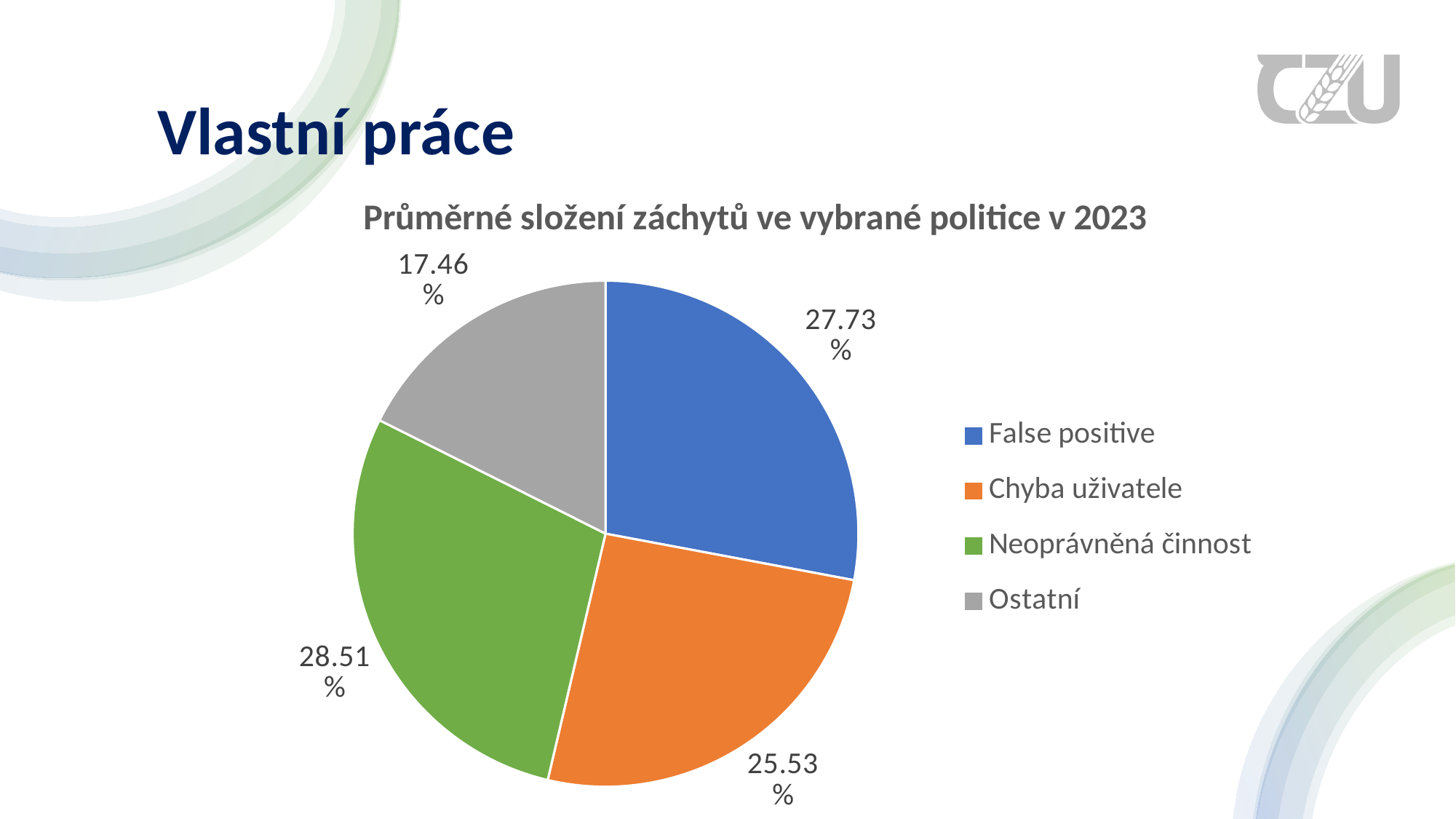
What percentage of the pie is Chyba uživatele? 25.53% Which category has the smallest share of the pie? Ostatní What is the difference between the shares of False positive and Ostatní? 10.27% What colour represents Chyba uživatele in the chart? orange Which category has the largest share of the pie? Neoprávněná činnost What is the title of the chart? Průměrné složení záchytů ve vybrané politice v 2023 Which is larger, the share of False positive or the share of Chyba uživatele? False positive How many categories does the pie chart show? 4 What percentage of the pie is Neoprávněná činnost? 28.51% What percentage of the pie is False positive? 27.73% What type of chart is shown on the slide? pie chart What percentage of the pie is Ostatní? 17.46%